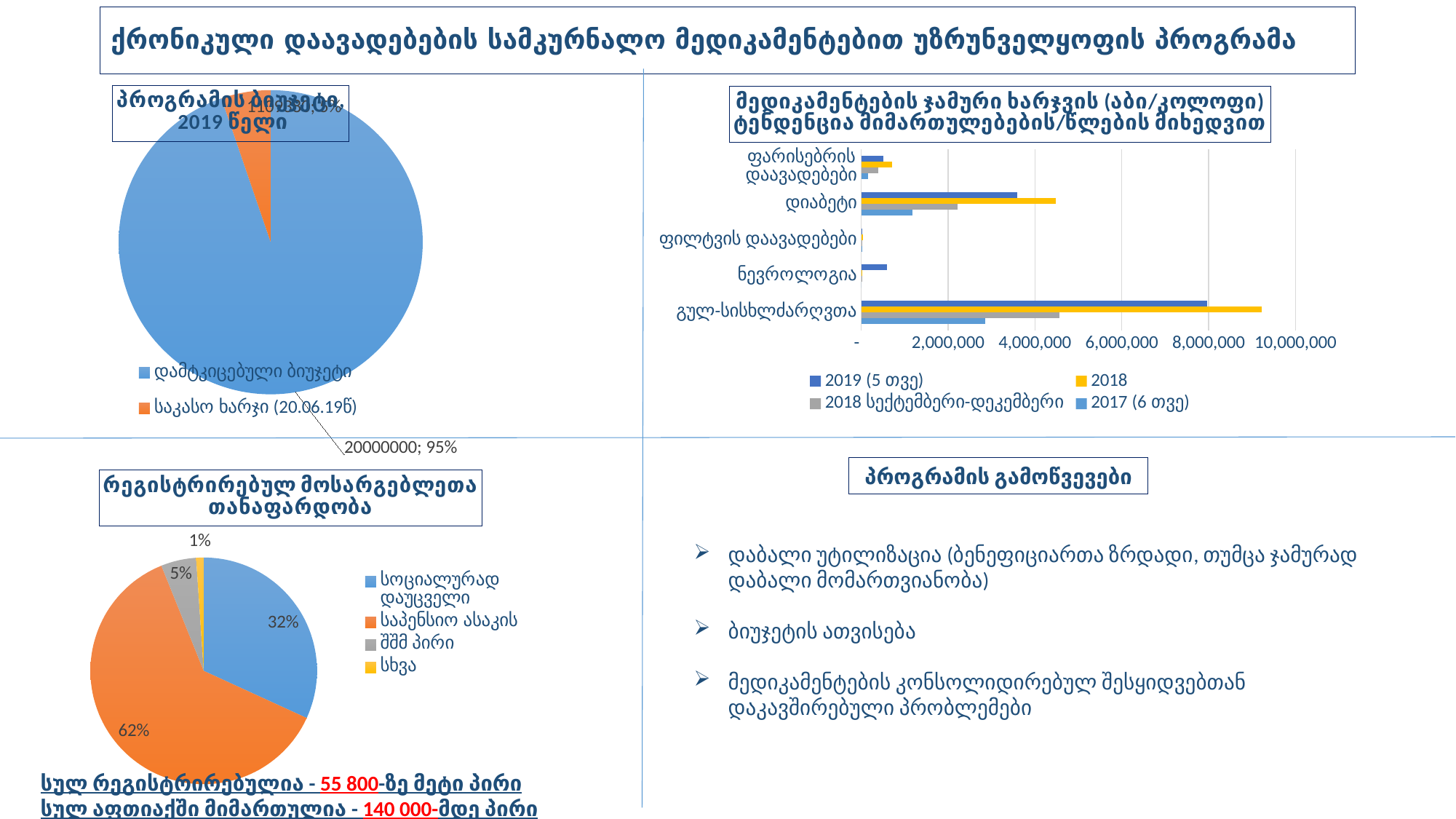
How many series does the legend of the top-right bar chart (მედიკამენტების ჯამური ხარჯის ტენდენცია) list? 4 In the bottom-left pie chart (რეგისტრირებულ მოსარგებლეთა თანაფარდობა), which category has the smallest slice? სხვა In the bottom-left pie chart (რეგისტრირებულ მოსარგებლეთა თანაფარდობა), what share is labelled for სოციალურად დაუცველი? 32% In the bottom-left pie chart (რეგისტრირებულ მოსარგებლეთა თანაფარდობა), how many percentage points larger is საპენსიო ასაკის than სოციალურად დაუცველი? 30 In the bottom-left pie chart (რეგისტრირებულ მოსარგებლეთა თანაფარდობა), what share is labelled for საპენსიო ასაკის? 62% In the top-left pie chart (პროგრამის ბიუჯეტი 2019 წელი), what share is labelled for the დამტკიცებული ბიუჯეტი slice? 95% In the top-left pie chart (პროგრამის ბიუჯეტი 2019 წელი), what value is labelled for the დამტკიცებული ბიუჯეტი slice? 20000000 What kind of chart is the top-right chart (მედიკამენტების ჯამური ხარჯის ტენდენცია)? bar chart In the top-right bar chart (მედიკამენტების ჯამური ხარჯის ტენდენცია), which category has the highest 2018 value? გულ-სისხლძარღვთა In the bottom-left pie chart (რეგისტრირებულ მოსარგებლეთა თანაფარდობა), which category has the largest slice? საპენსიო ასაკის How many categories does the bottom-left pie chart (რეგისტრირებულ მოსარგებლეთა თანაფარდობა) list in its legend? 4 In the top-right bar chart (მედიკამენტების ჯამური ხარჯის ტენდენცია), is the 2018 value for გულ-სისხლძარღვთა greater or less than 8,000,000? greater